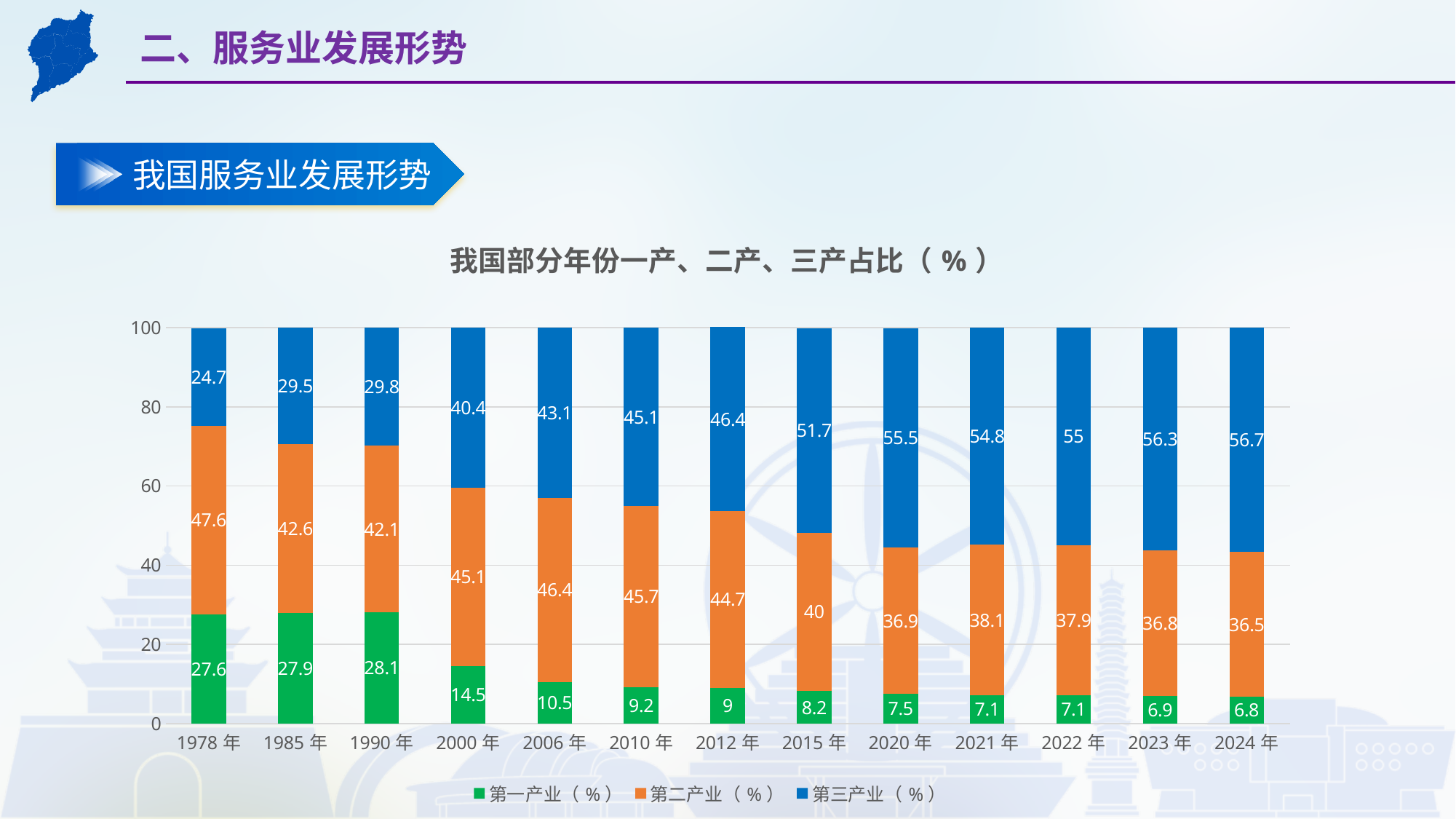
What is the value for 第二产业 in 1978 年? 47.6 Which is larger in 2010 年, 第二产业 or 第三产业? 第二产业 In which year is the 第三产业 share highest? 2024 年 What is the difference between the 第三产业 and 第一产业 values in 2024 年? 49.9 How many series does the legend list? 3 How many years are shown on the x axis? 13 What is the value for 第三产业 in 2024 年? 56.7 What kind of chart is shown on the slide? Stacked bar chart In which year is the 第一产业 share lowest? 2024 年 What is the value for 第一产业 in 2000 年? 14.5 Does the 第一产业 share rise or fall from 1990 年 to 2024 年? Fall What is the title of the chart? 我国部分年份一产、二产、三产占比（%）